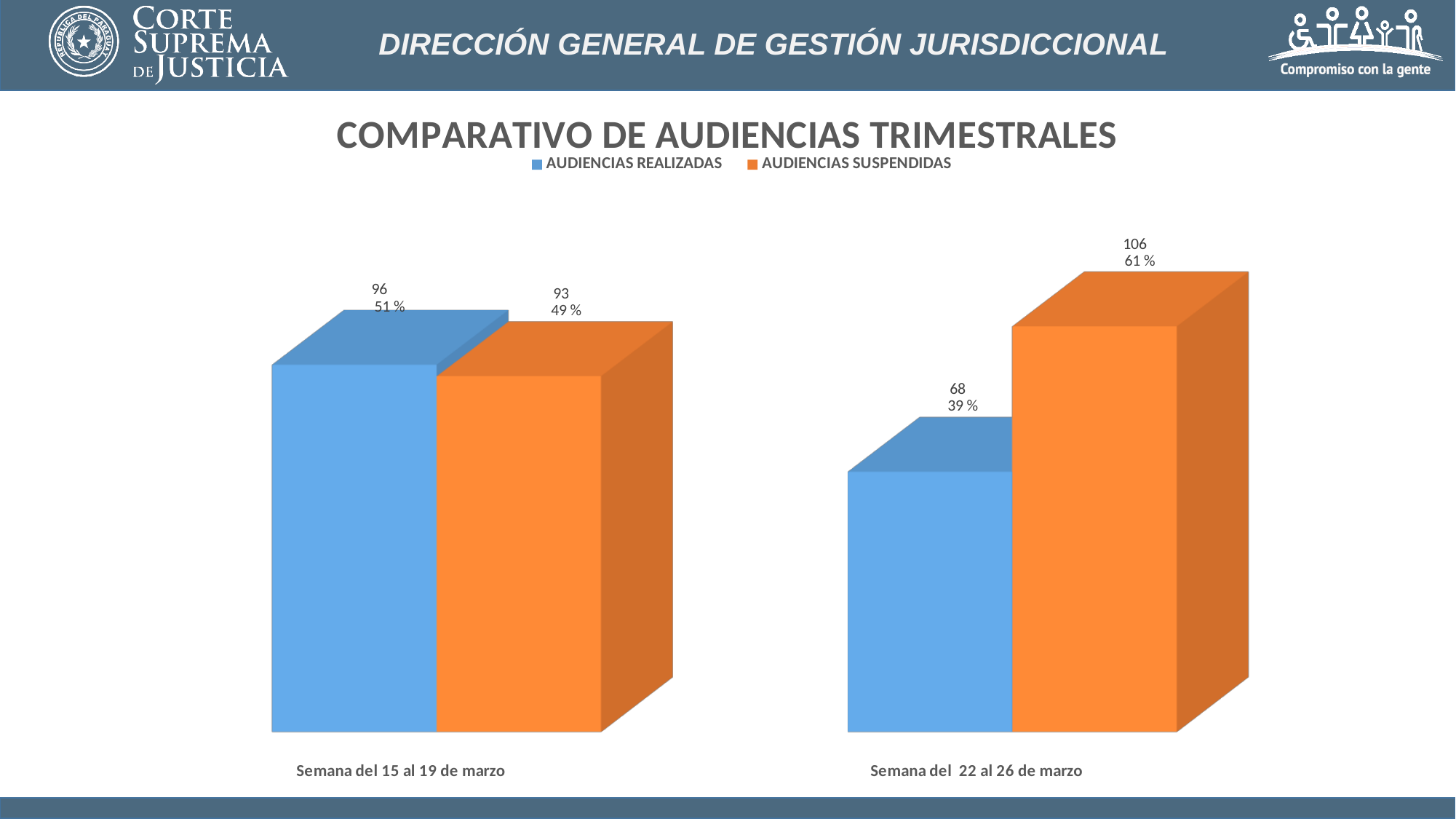
What is the difference between AUDIENCIAS SUSPENDIDAS and AUDIENCIAS REALIZADAS in the week 'Semana del 22 al 26 de marzo'? 38 How many series does the legend list? 2 What is the value for AUDIENCIAS SUSPENDIDAS in the week 'Semana del 15 al 19 de marzo'? 93 What kind of chart is shown on the slide? Bar chart What is the difference in AUDIENCIAS REALIZADAS between the week of 15 al 19 de marzo and the week of 22 al 26 de marzo? 28 How many week categories are shown on the x axis? 2 What is the value for AUDIENCIAS REALIZADAS in the week 'Semana del 15 al 19 de marzo'? 96 Which bar has the lowest value on the chart? AUDIENCIAS REALIZADAS, Semana del 22 al 26 de marzo What is the value for AUDIENCIAS SUSPENDIDAS in the week 'Semana del 22 al 26 de marzo'? 106 What percentage is shown for AUDIENCIAS REALIZADAS in the week 'Semana del 22 al 26 de marzo'? 39 % Which bar has the highest value on the chart? AUDIENCIAS SUSPENDIDAS, Semana del 22 al 26 de marzo Which is larger in the week 'Semana del 22 al 26 de marzo': AUDIENCIAS REALIZADAS or AUDIENCIAS SUSPENDIDAS? AUDIENCIAS SUSPENDIDAS